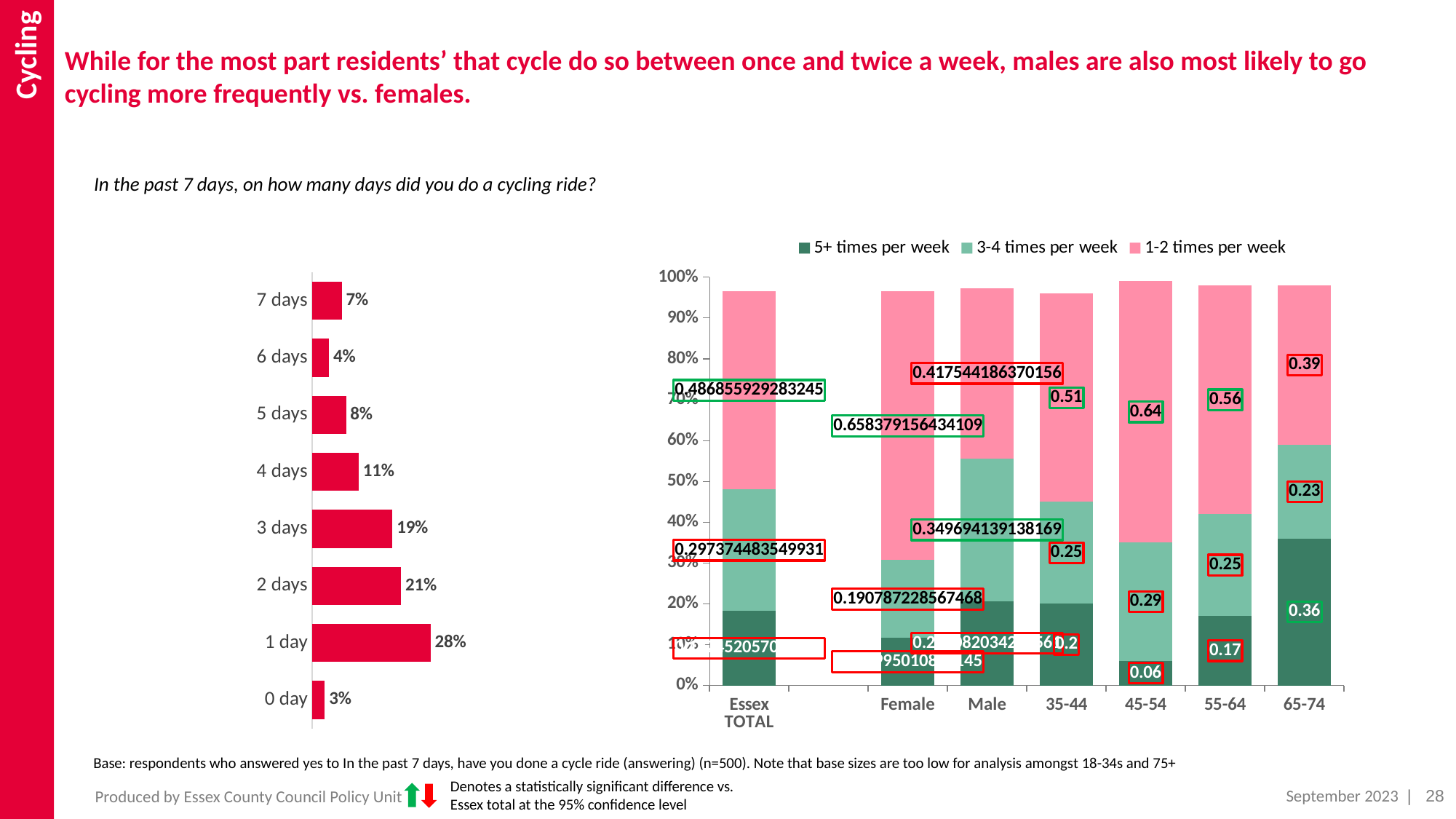
In the left bar chart, what percentage of respondents cycled on 7 days? 7% What type of chart is the chart on the left? Bar chart In the right stacked bar chart, which is larger for 5+ times per week: 55-64 or 45-54? 55-64 In the left bar chart, which category has the highest value? 1 day In the right stacked bar chart, what is the value for 1-2 times per week for the 45-54 group? 0.64 In the right stacked bar chart, how many categories are shown on the x axis? 7 In the left bar chart, how many categories are shown? 8 In the right stacked bar chart, what is the value for 5+ times per week for the 65-74 group? 0.36 In the left bar chart, which category has the lowest value? 0 day In the left bar chart, what is the difference between the values for 2 days and 3 days? 2% In the left bar chart, what percentage of respondents cycled on 1 day in the past 7 days? 28% In the right stacked bar chart, how many series does the legend list? 3